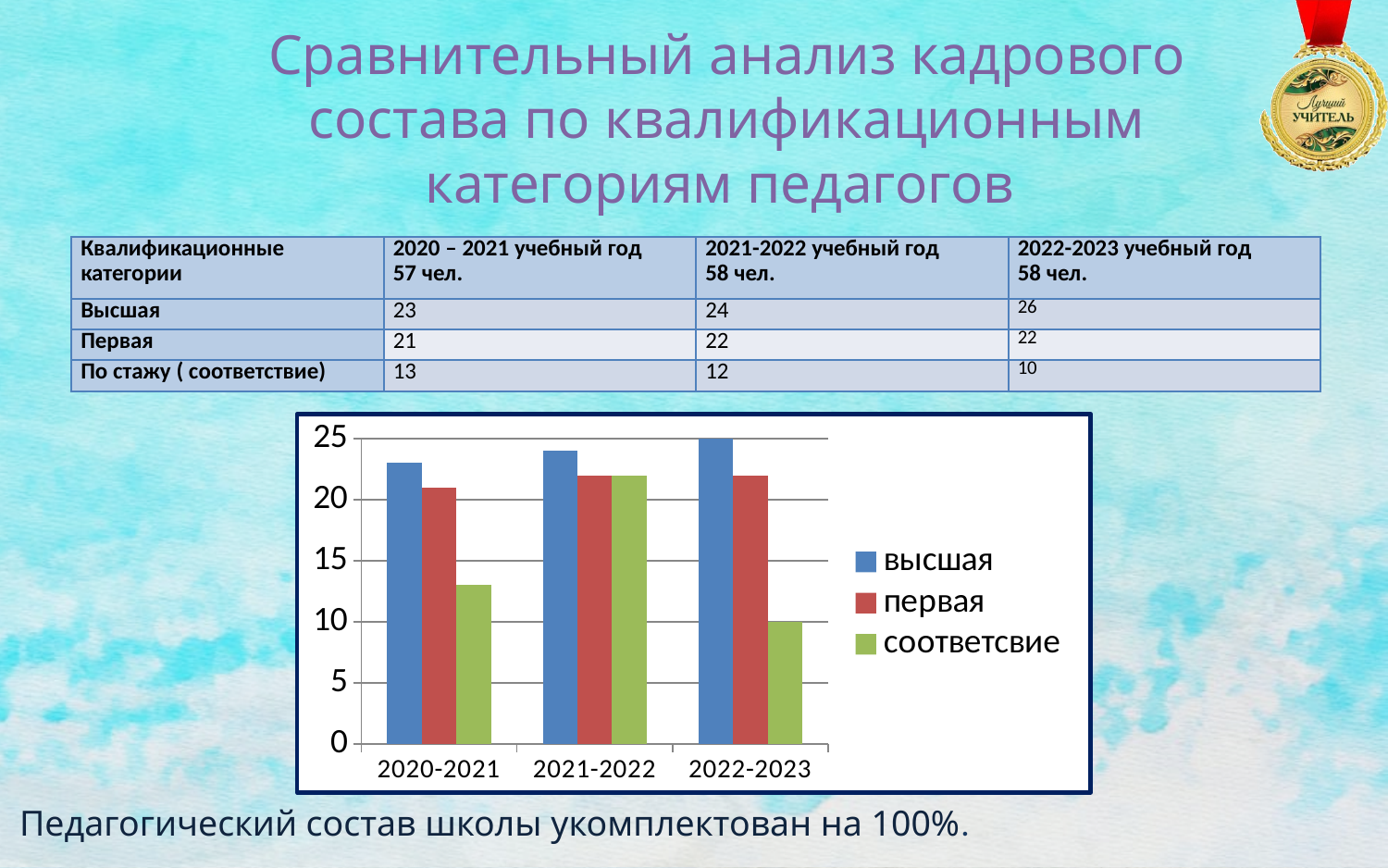
Is the value of the соответсвие bar for 2021-2022 greater or less than 20? greater Is the value of the соответсвие bar for 2020-2021 greater or less than 15? less In the 2020-2021 group, which series has the highest bar? высшая What is the value of the соответсвие bar for 2022-2023 in the chart? 10 Do the соответсвие bars rise or fall from 2021-2022 to 2022-2023? fall In the 2020-2021 group, which series has the lowest bar? соответсвие Is the value of the высшая bar for 2020-2021 greater or less than 20? greater Which series is shown in green in the chart? соответсвие What kind of chart is shown on the slide? bar chart How many school-year categories are shown on the x axis of the chart? 3 For 2022-2023, which is larger: the высшая bar or the соответсвие bar? высшая How many series does the chart legend list? 3